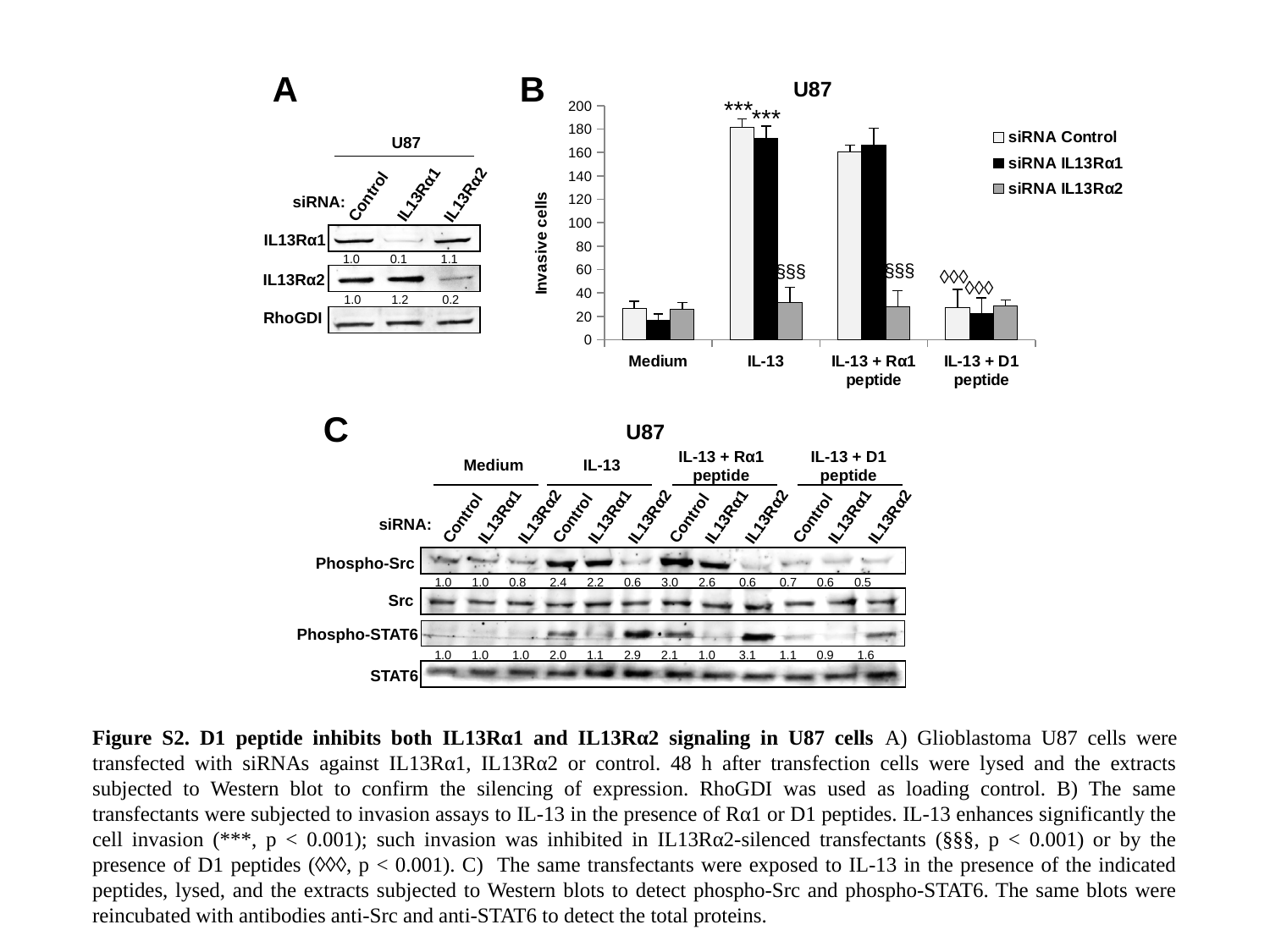
What is the label of the y axis in the panel B chart? Invasive cells In the panel B chart, is the siRNA IL13Rα1 value for IL-13 + Rα1 peptide greater or less than 140? greater In the panel B chart, is the siRNA IL13Rα2 value for IL-13 greater or less than 60? less What is the title of the panel B chart? U87 How many categories are shown on the x axis of the panel B chart? 4 In the panel B chart, which is larger for the IL-13 + Rα1 peptide category: the siRNA IL13Rα1 value or the siRNA IL13Rα2 value? siRNA IL13Rα1 In the panel B chart, which category has the highest siRNA Control value? IL-13 In the panel B chart, which is larger for the IL-13 category: the siRNA Control value or the siRNA IL13Rα2 value? siRNA Control How many series does the legend of the panel B chart list? 3 In the panel B chart, is the siRNA Control value for IL-13 greater or less than 160? greater What kind of chart is shown in panel B? bar chart